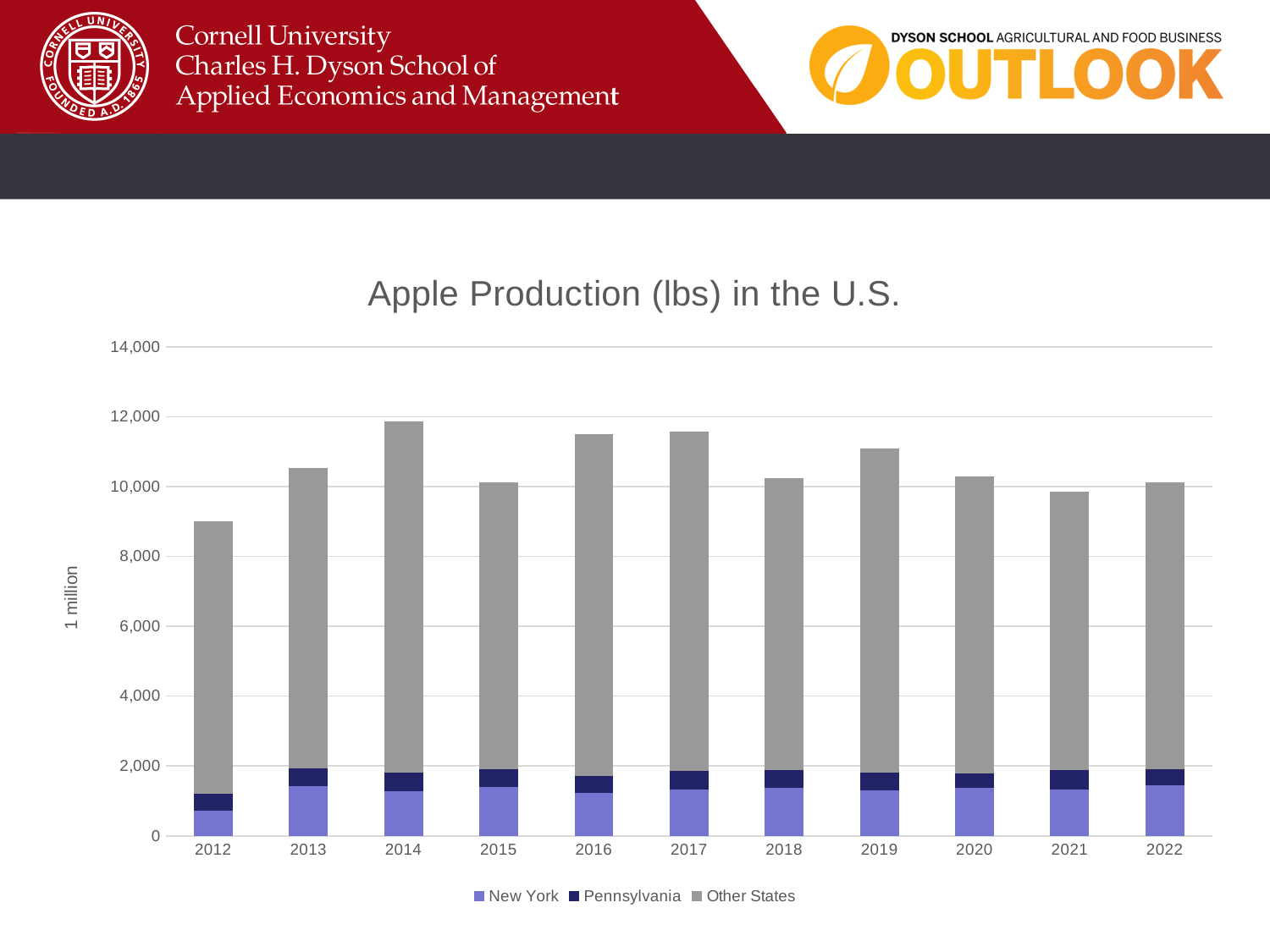
Which year has the lowest total apple production? 2012 Is the total value for 2014 greater or less than 10,000? greater Which year has the larger New York value, 2012 or 2013? 2013 Is the total value for 2012 greater or less than 10,000? less Which year has the larger total apple production, 2012 or 2013? 2013 How many years are shown on the x axis? 11 How many series does the legend list? 3 Which year has the highest total apple production? 2014 What is the title of the chart? Apple Production (lbs) in the U.S. Is the total value for 2019 greater or less than 12,000? less Which series is shown in grey in the chart? Other States What kind of chart is shown on the slide? Stacked bar chart